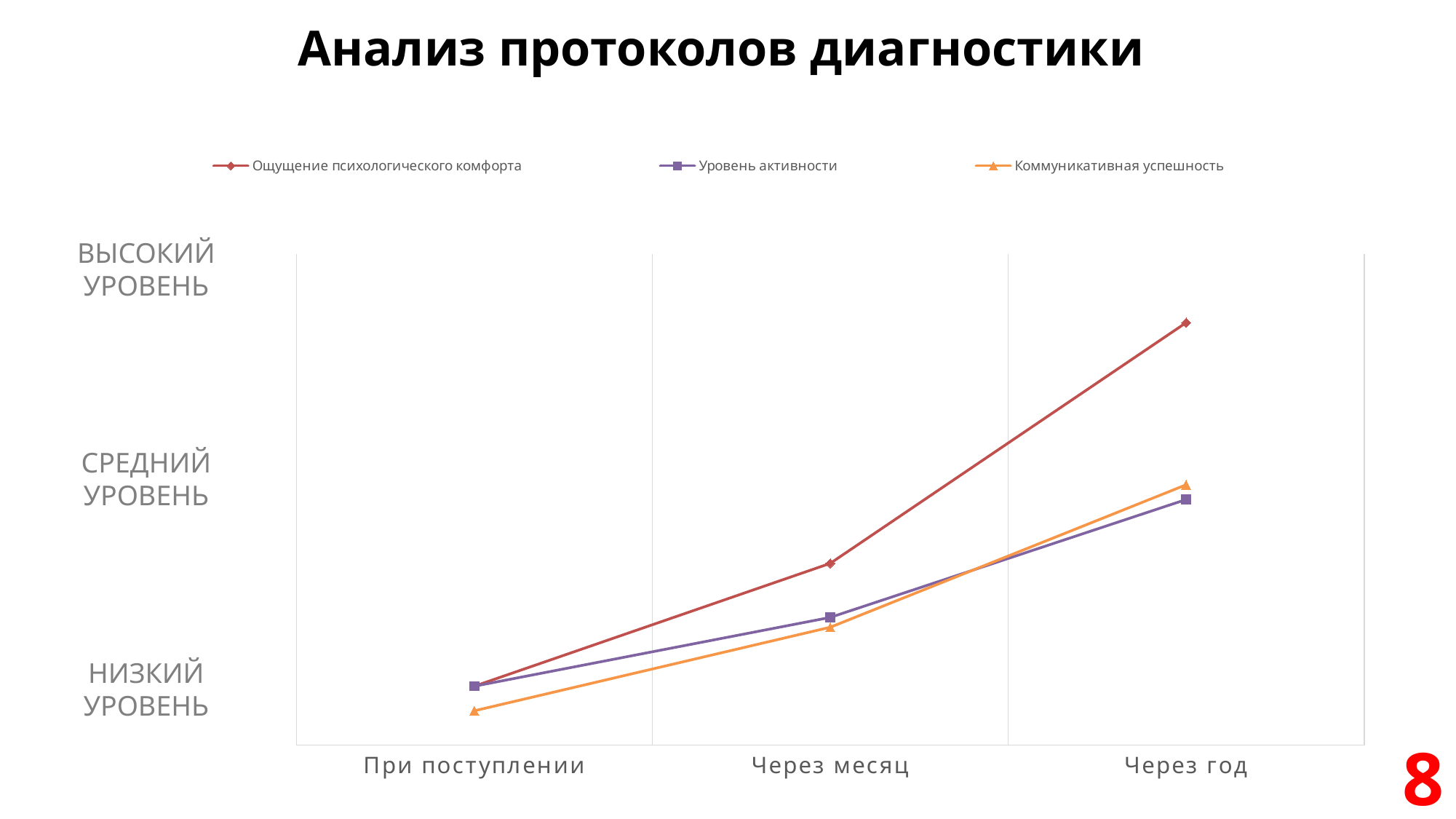
Which series has the highest value at "Через год"? Ощущение психологического комфорта Which series has the lowest value at "Через год"? Уровень активности What is the title of the slide? Анализ протоколов диагностики What kind of chart is shown on the slide? Line chart Do the values for Коммуникативная успешность rise or fall along the x axis? Rise Do the values for Уровень активности rise or fall from "При поступлении" to "Через год"? Rise Which series has the lowest value at "При поступлении"? Коммуникативная успешность How many series does the legend list? 3 At "Через год", which is higher: Коммуникативная успешность or Ощущение психологического комфорта? Ощущение психологического комфорта Which series is drawn in red with diamond markers? Ощущение психологического комфорта How many categories are shown on the x axis? 3 At "Через месяц", which is higher: Ощущение психологического комфорта or Уровень активности? Ощущение психологического комфорта